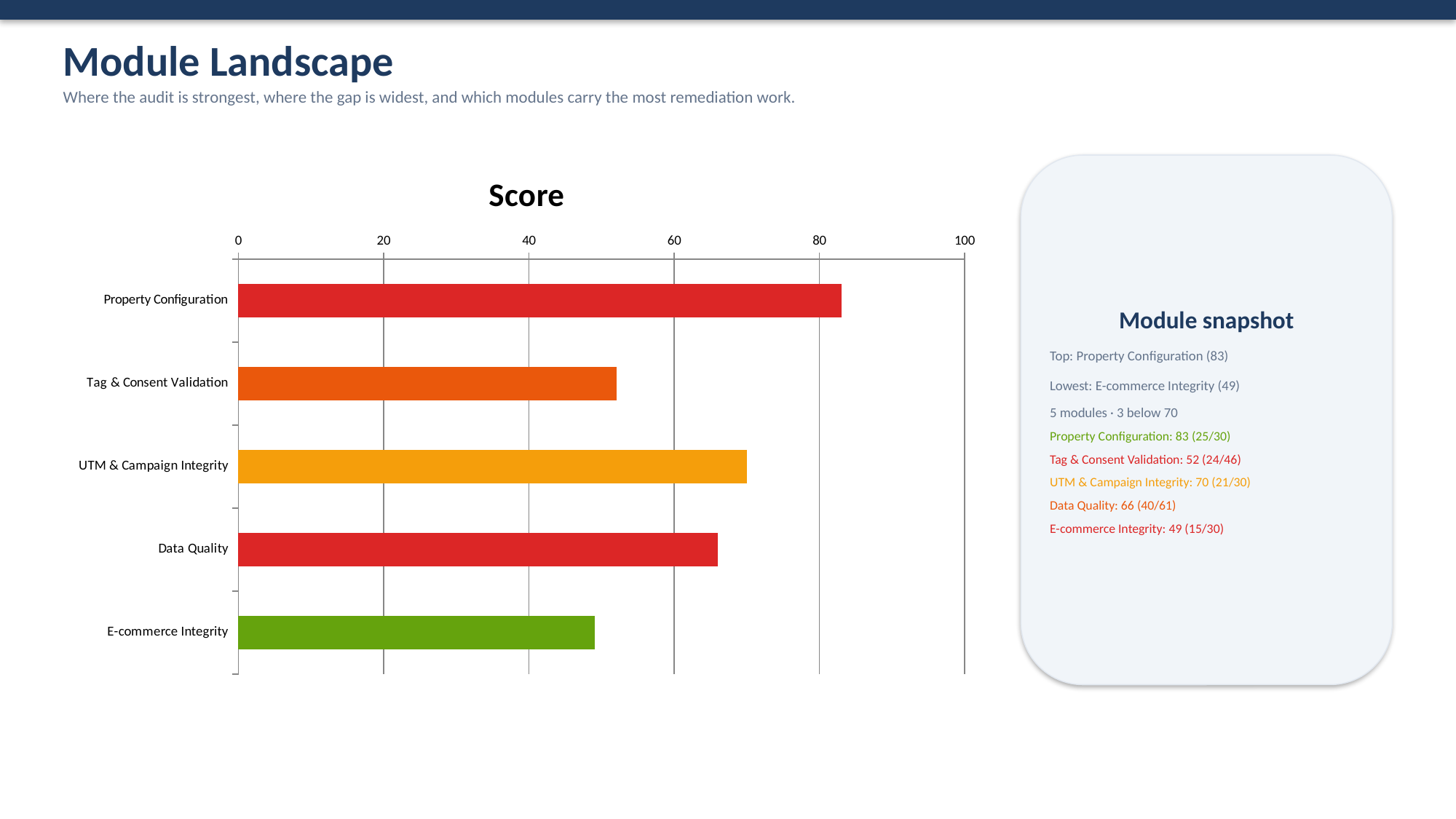
Which has a higher score, UTM & Campaign Integrity or Tag & Consent Validation? UTM & Campaign Integrity Which module has the lowest score in the chart? E-commerce Integrity What type of chart is shown on the slide? Bar chart What is the title of the chart? Score What is the score for Data Quality? 66 Is the value for Property Configuration greater or less than 80? greater Is the value for Tag & Consent Validation greater or less than 60? less What is the score for E-commerce Integrity? 49 How many modules are plotted in the Score chart? 5 What is the score for Property Configuration? 83 What is the difference between the scores of Property Configuration and E-commerce Integrity? 34 Which module has the highest score in the chart? Property Configuration